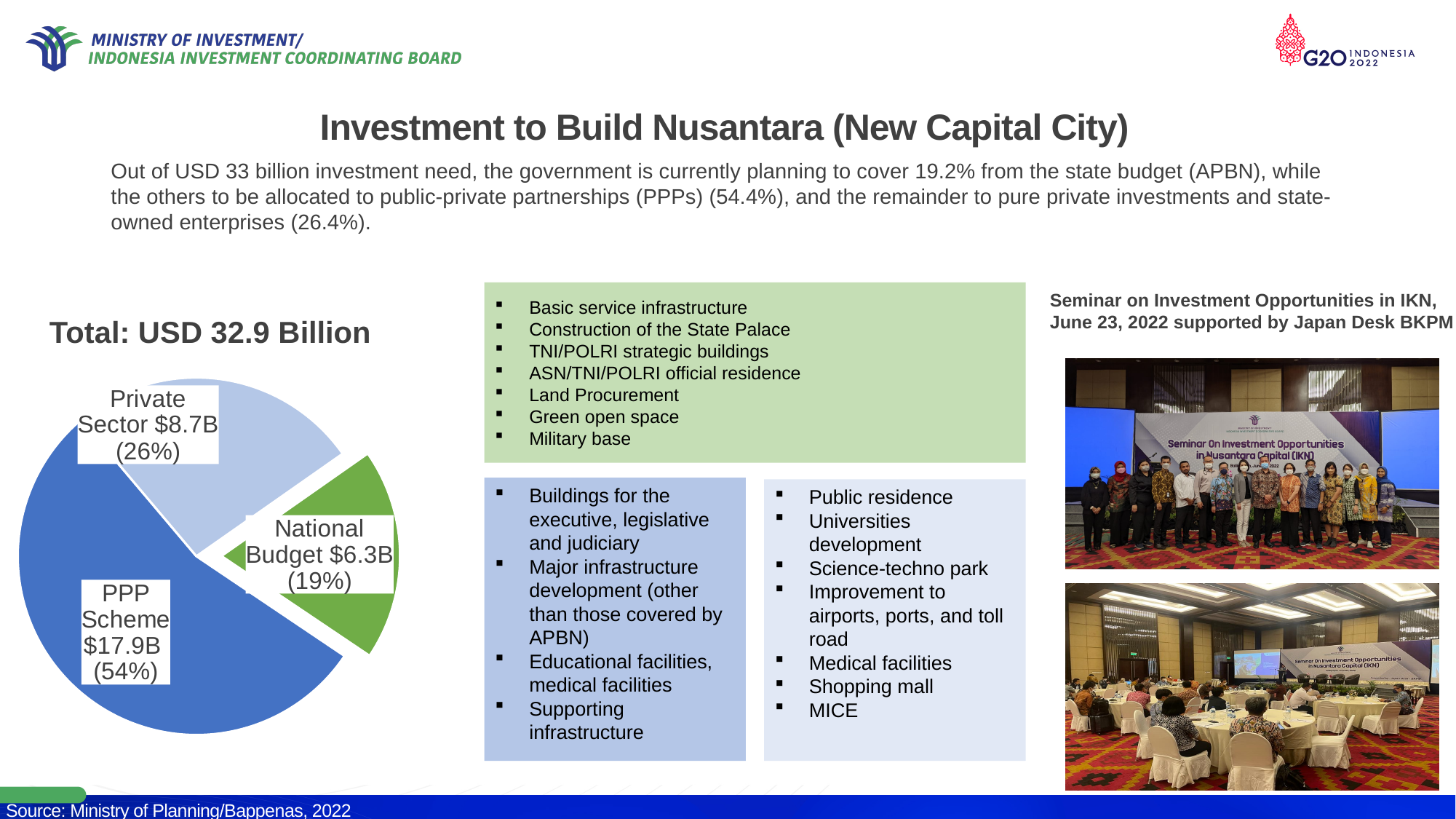
Which is larger, the Private Sector slice or the National Budget slice? Private Sector What total is stated above the pie chart? Total: USD 32.9 Billion How many slices does the pie chart have? 3 What kind of chart is shown on the slide? pie chart Which slice of the pie chart is the largest? PPP Scheme Which slice of the pie chart is the smallest? National Budget What is the value shown for the PPP Scheme slice? $17.9B What is the value shown for the Private Sector slice? $8.7B What is the value shown for the National Budget slice? $6.3B What share of the pie does the National Budget slice represent? 19% What share of the pie does the PPP Scheme slice represent? 54% What is the difference in value between the PPP Scheme slice and the Private Sector slice? $9.2B